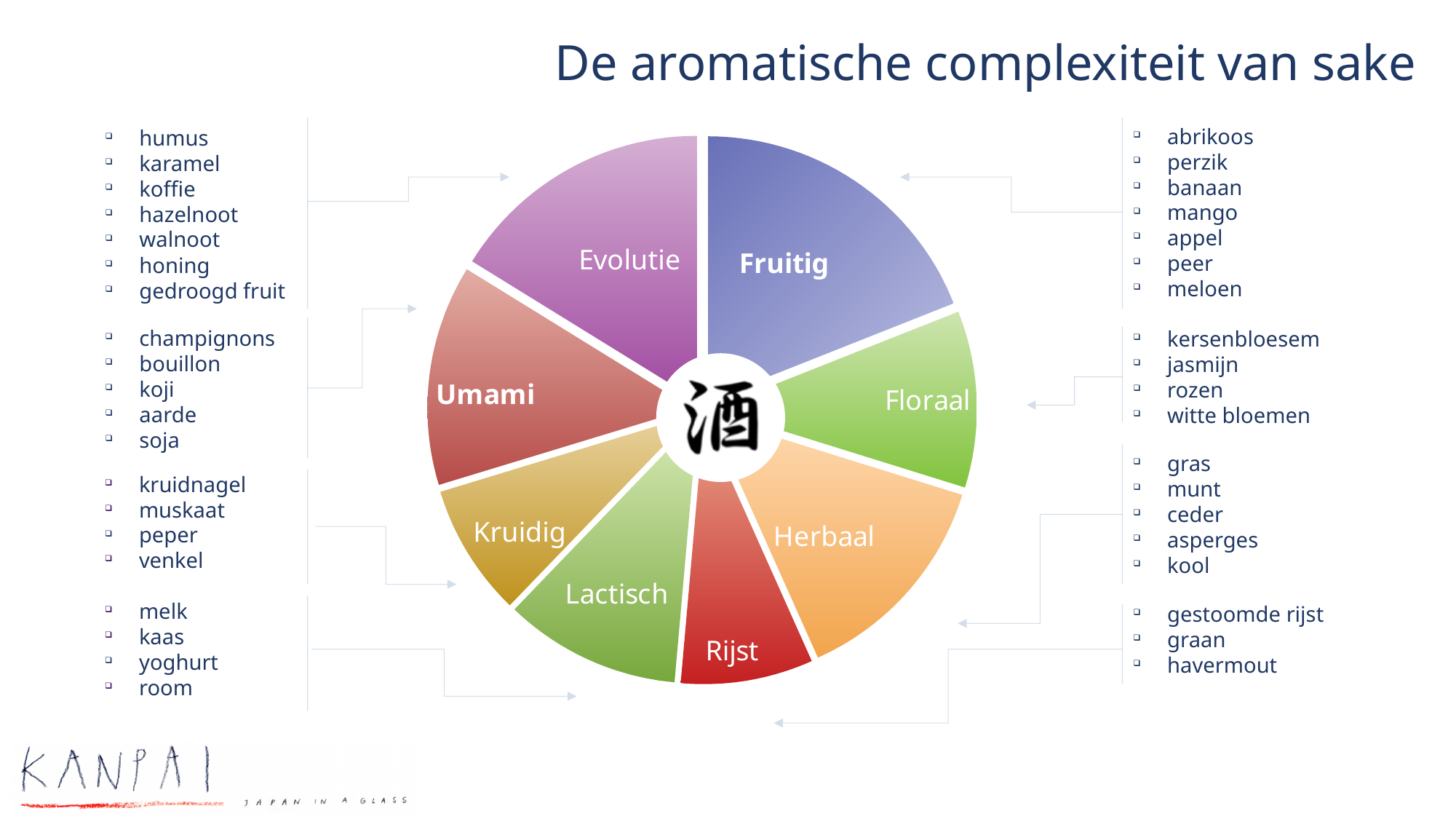
Which segment of the pie chart is the largest? Fruitig How many segments does the pie chart have? 8 What colour is the Fruitig segment of the pie chart? blue Which segment is larger, Umami or Rijst? Umami Which segment is larger, Fruitig or Rijst? Fruitig What kind of chart is shown on the slide? pie chart Which segment is larger, Herbaal or Rijst? Herbaal What is the title of the slide containing the pie chart? De aromatische complexiteit van sake